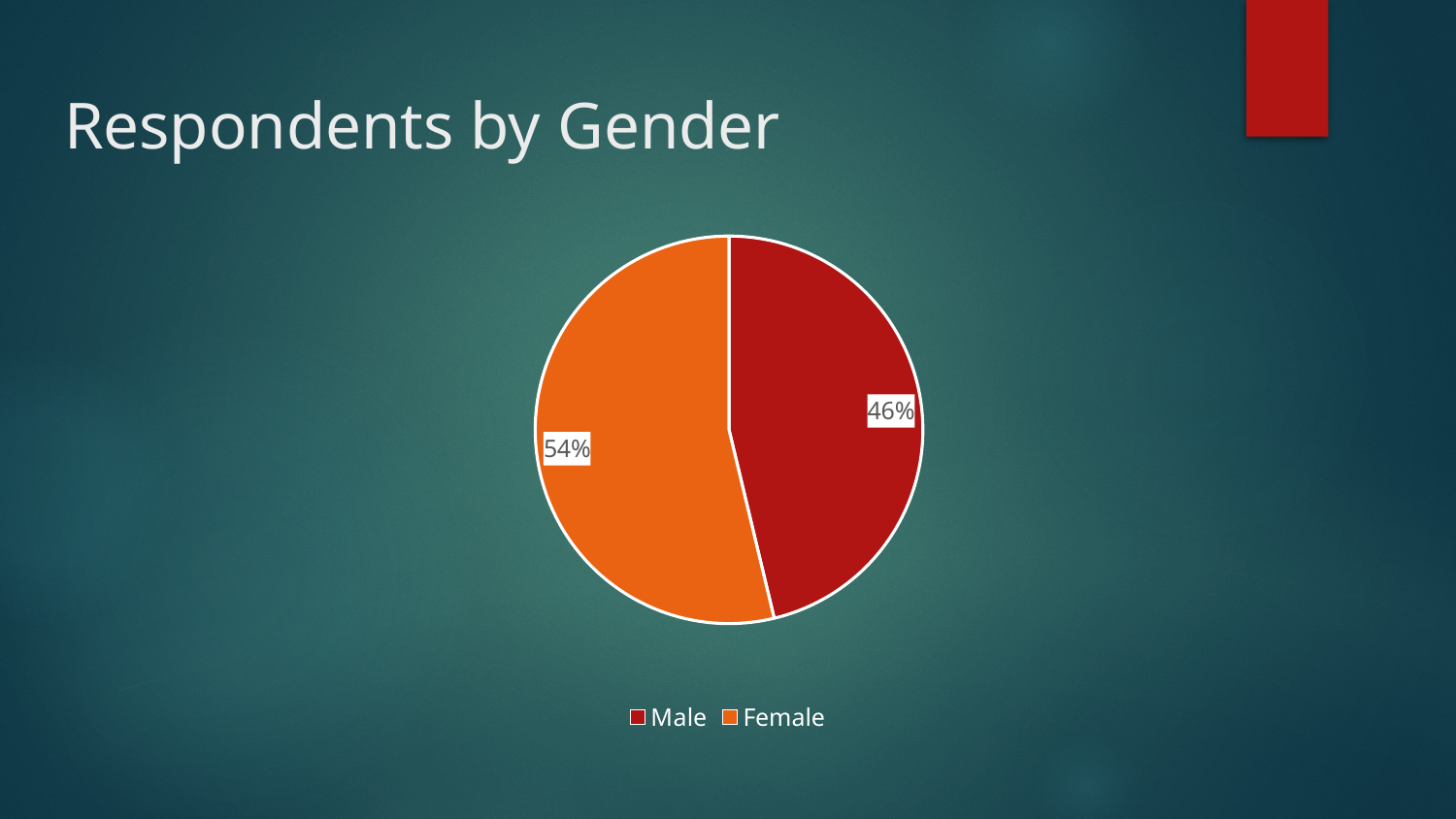
How many categories does the pie chart show? 2 What percentage of respondents are Male? 46% What percentage of respondents are Female? 54% Which gender has the smaller share of respondents? Male Is the Female share greater or less than 50%? greater Is the Male share larger or smaller than the Female share? smaller What colour represents Female in the pie chart? orange What kind of chart is shown on the slide? pie chart Which gender has the larger share of respondents? Female What is the title of the slide? Respondents by Gender What is the difference in percentage points between the Female and Male shares? 8